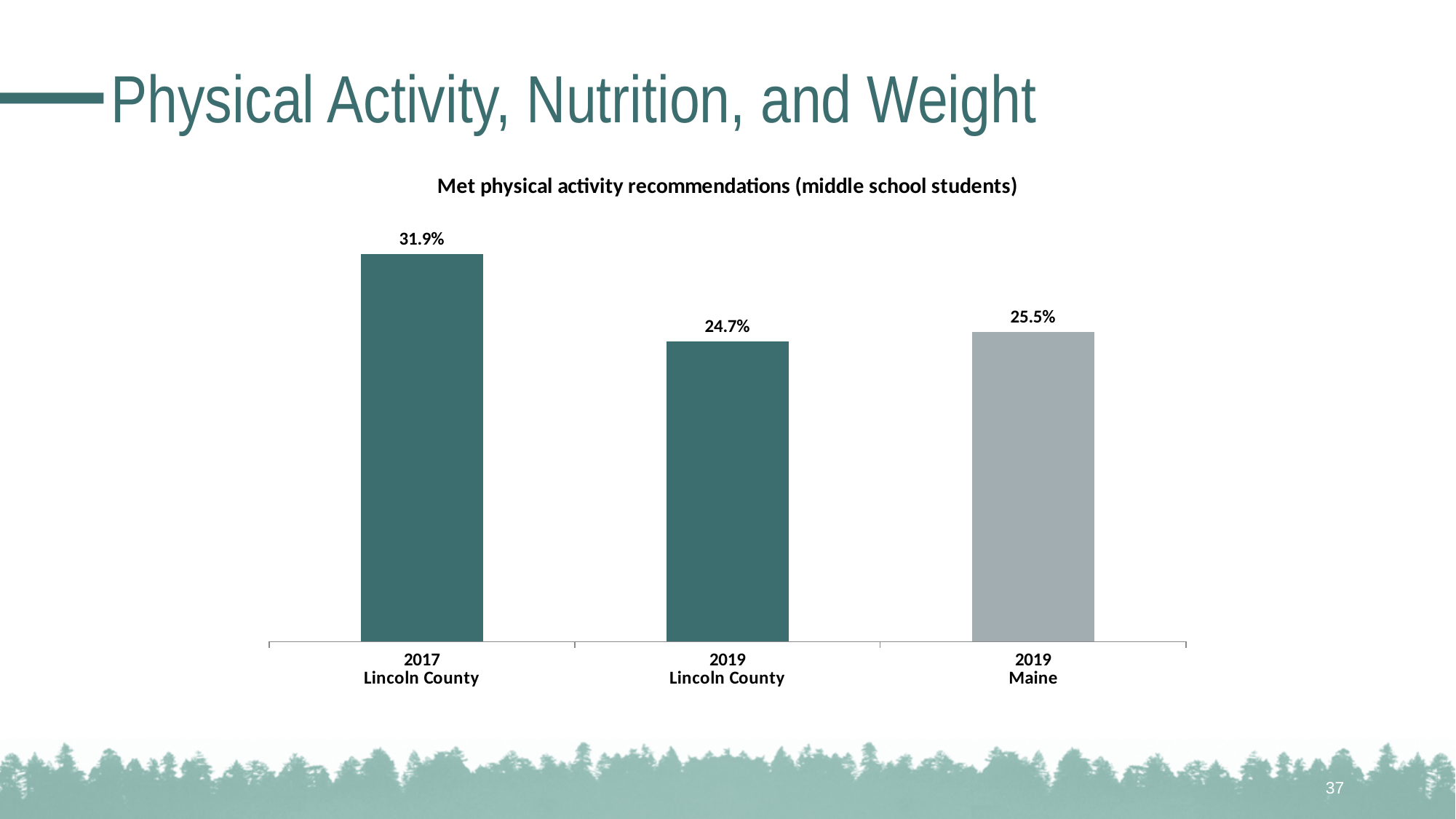
Which category has the lowest value? 2019 Lincoln County What is the difference between the 2017 Lincoln County value and the 2019 Lincoln County value? 7.2% How many bars are shown in the chart? 3 What is the title of the chart? Met physical activity recommendations (middle school students) What is the value for 2019 Maine? 25.5% Which category has the highest value? 2017 Lincoln County What kind of chart is shown on the slide? Bar chart What is the difference between the 2019 Maine value and the 2019 Lincoln County value? 0.8% Which is larger, the value for 2017 Lincoln County or the value for 2019 Maine? 2017 Lincoln County What is the value for 2019 Lincoln County? 24.7% What is the value for 2017 Lincoln County? 31.9% Did the Lincoln County value rise or fall from 2017 to 2019? Fall